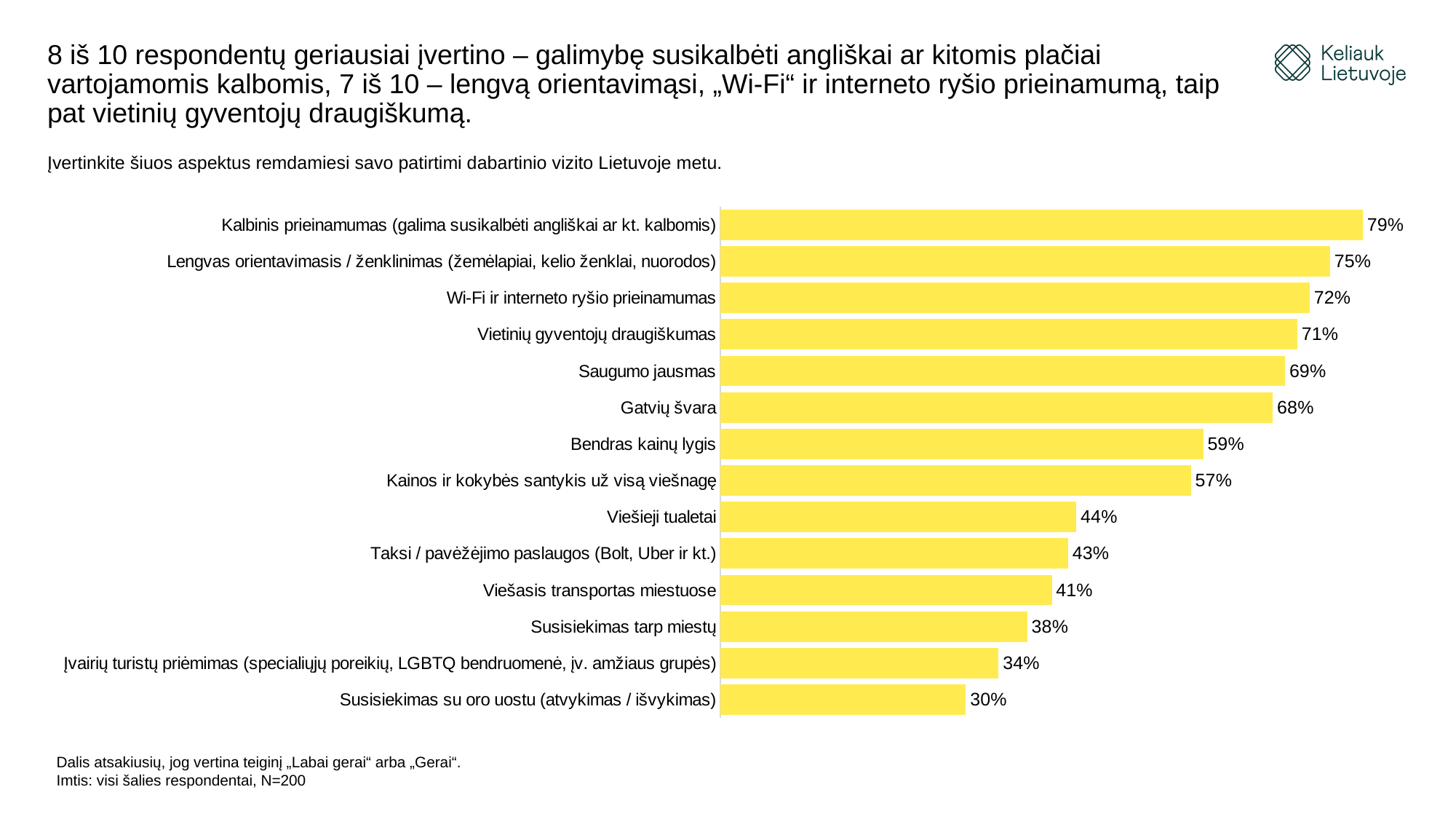
What is the difference between the values for "Gatvių švara" and "Bendras kainų lygis"? 9% Which category has the lowest value? Susisiekimas su oro uostu (atvykimas / išvykimas) What is the difference between the highest and lowest values on the chart? 49% What is the value for "Wi-Fi ir interneto ryšio prieinamumas"? 72% What is the value for "Viešieji tualetai"? 44% What is the value for "Saugumo jausmas"? 69% Which is larger: the value for "Susisiekimas tarp miestų" or the value for "Viešasis transportas miestuose"? Viešasis transportas miestuose What is the value for "Įvairių turistų priėmimas (specialiųjų poreikių, LGBTQ bendruomenė, įv. amžiaus grupės)"? 34% What kind of chart is shown on the slide? Bar chart What colour are the bars on the chart? Yellow Which category has the highest value? Kalbinis prieinamumas (galima susikalbėti angliškai ar kt. kalbomis) How many categories are shown on the chart? 14